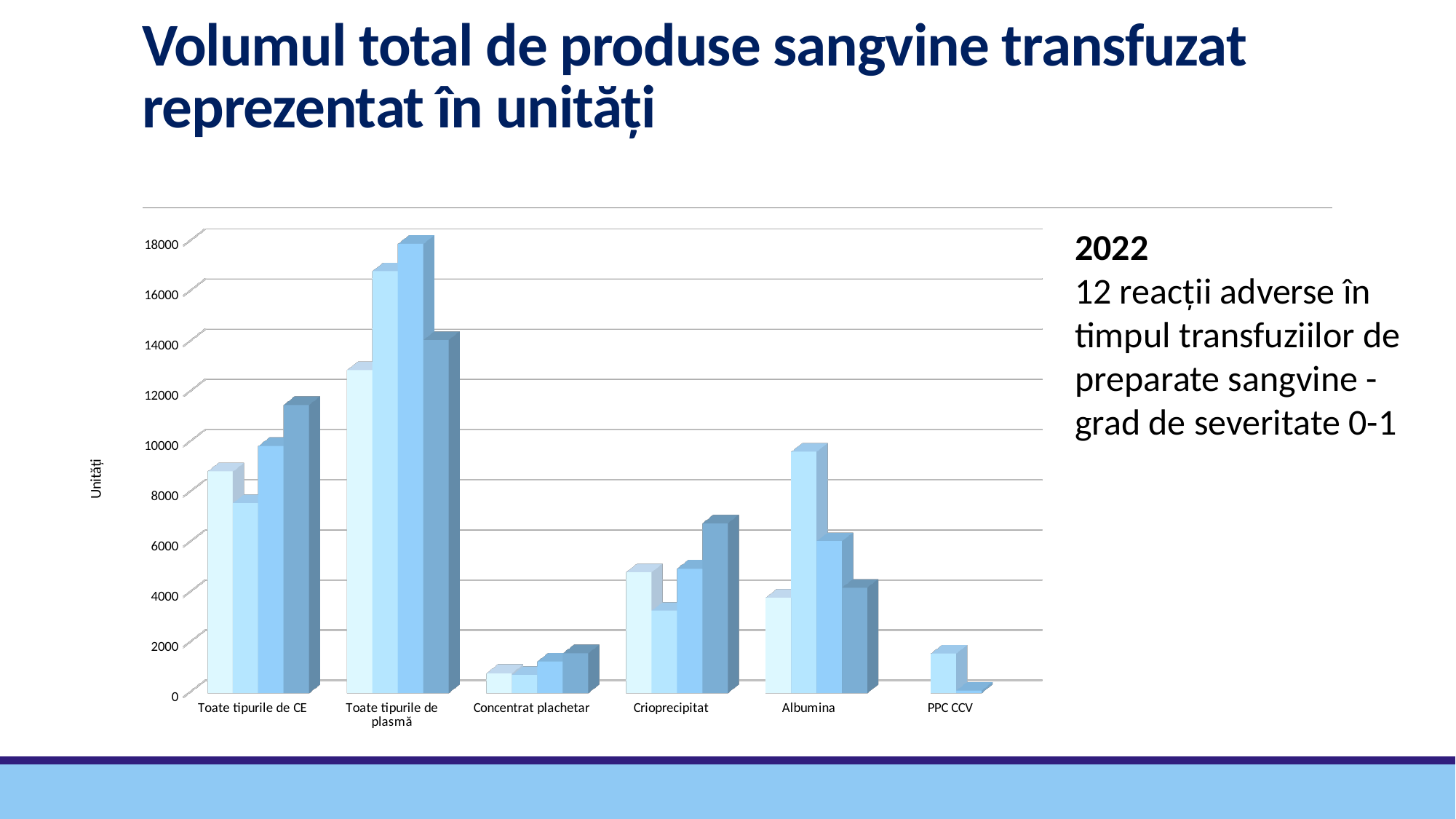
Which category contains the tallest bar in the chart? Toate tipurile de plasmă What is the label on the vertical axis of the chart? Unități Is the first bar for Toate tipurile de CE greater or less than 8000? greater How many categories are shown on the x axis of the chart? 6 How many bars are plotted for the category Toate tipurile de CE? 4 Which category has the lowest bars overall in the chart? PPC CCV Which category has higher bars, Albumina or Concentrat plachetar? Albumina Is the tallest bar for Toate tipurile de plasmă greater or less than 16000? greater Which category has higher bars, Toate tipurile de plasmă or Toate tipurile de CE? Toate tipurile de plasmă What kind of chart is shown on the slide? bar chart Are all the bars for Concentrat plachetar greater or less than 2000? less